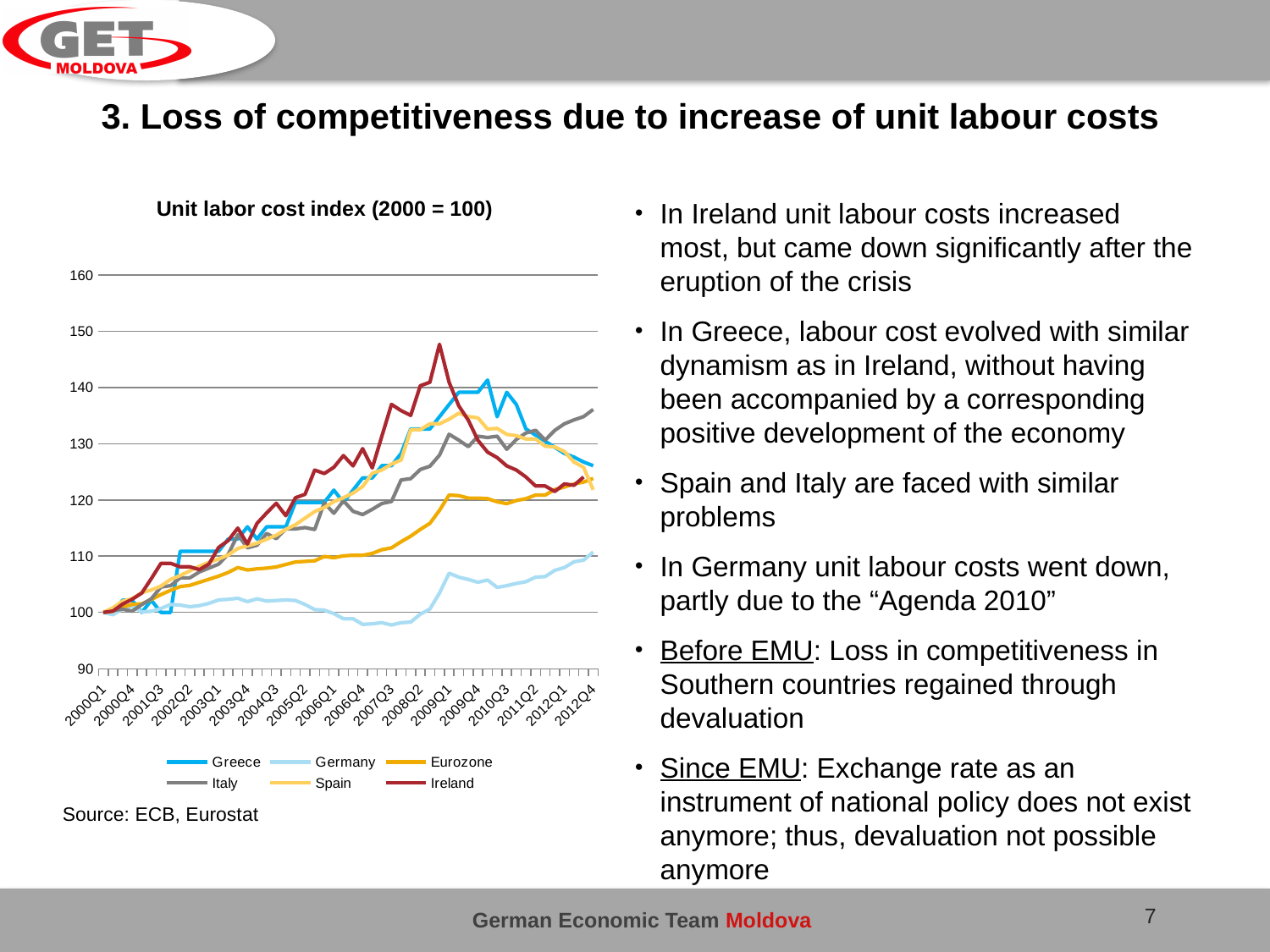
Is the value for Italy at 2012Q4 greater or less than 130? greater Which series stays lowest over the period shown on the chart? Germany What is the source given below the chart? ECB, Eurostat What is the title of the chart? Unit labor cost index (2000 = 100) Is the peak value for Ireland greater or less than 140? greater Which series reaches the highest value on the chart? Ireland Does the Eurozone series rise or fall from 2000Q1 to 2012Q4? rise What kind of chart is shown on the slide? line chart How many series does the legend of the chart list? 6 Is the value for the Eurozone at 2012Q4 greater or less than 120? greater At 2012Q4, which is higher: the value for Italy or the value for Germany? Italy